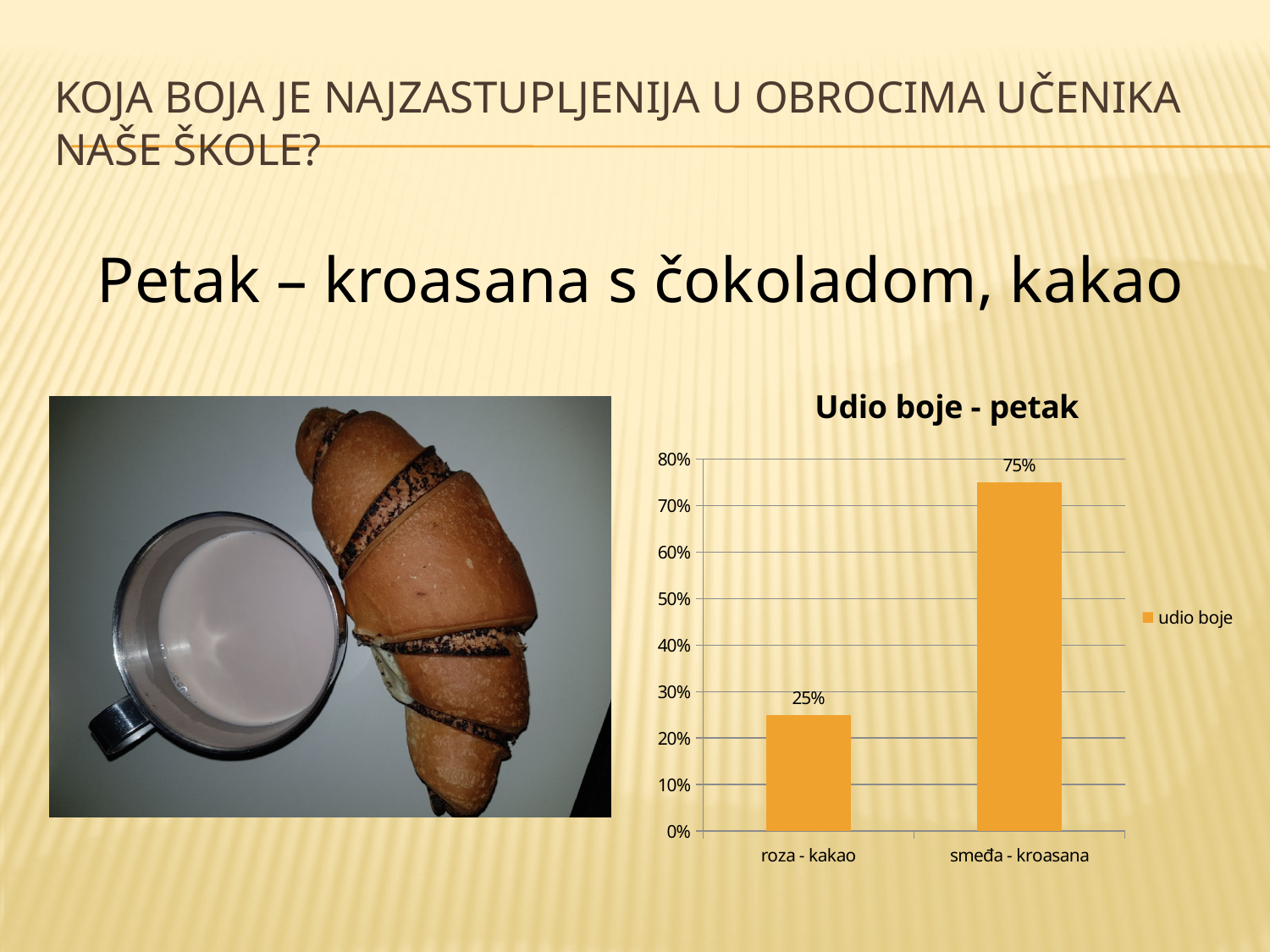
What kind of chart is shown? bar chart Is the value for smeđa - kroasana greater or less than 50%? greater What is the difference between the values for smeđa - kroasana and roza - kakao? 50% What is the value for smeđa - kroasana? 75% How many categories are shown on the x axis? 2 Which category has the highest value? smeđa - kroasana Is the value for roza - kakao greater or less than 40%? less Which is larger, the value for roza - kakao or the value for smeđa - kroasana? smeđa - kroasana What is the value for roza - kakao? 25% Which category has the lowest value? roza - kakao How many series does the legend list? 1 What is the title of the chart? Udio boje - petak